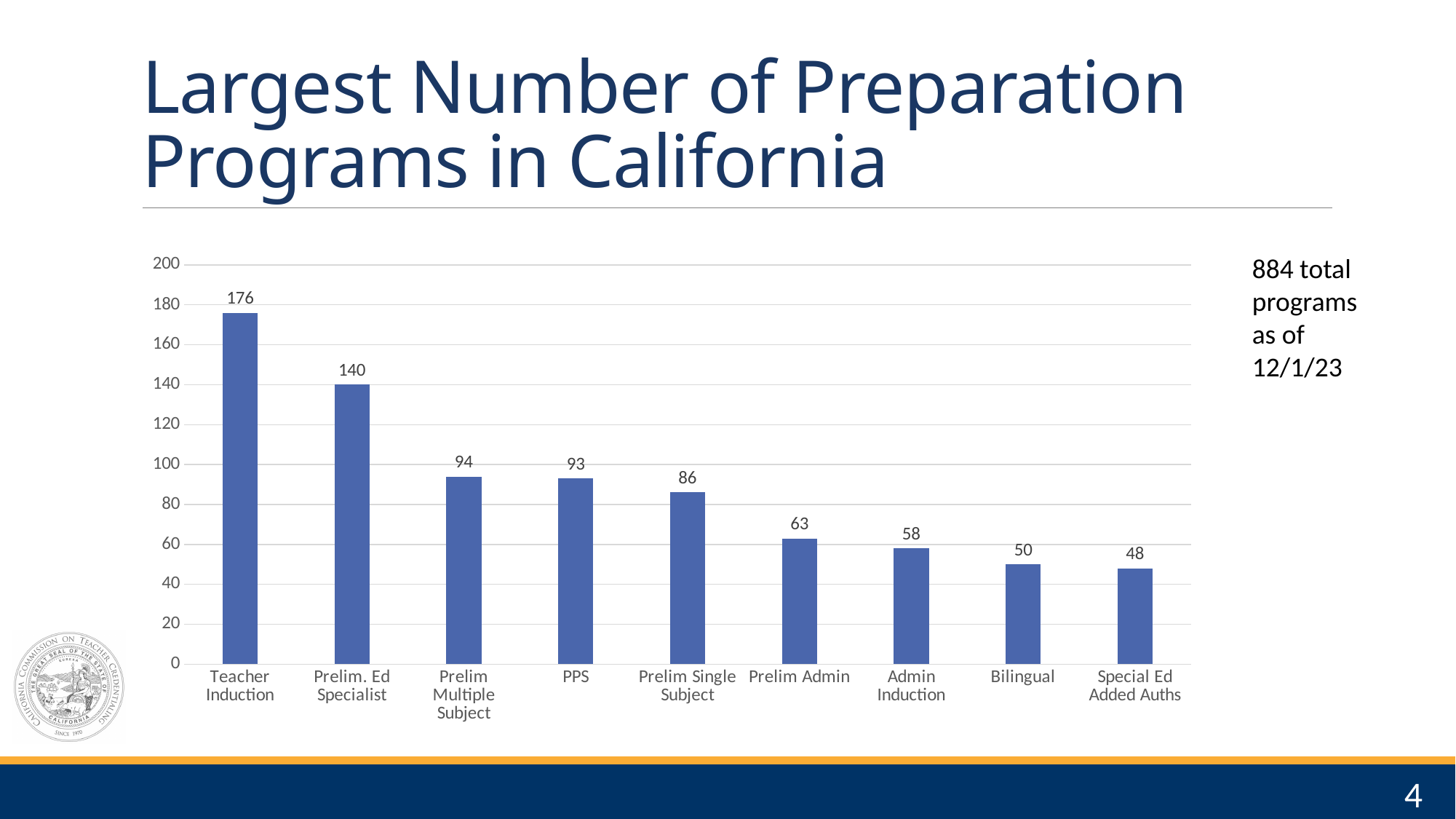
Do the values rise or fall from left to right along the x axis? fall Is the value for PPS greater or less than 100? less Which category has the lowest value? Special Ed Added Auths Which category has the highest value? Teacher Induction What is the value for Bilingual? 50 What is the value for Prelim Single Subject? 86 How many categories are shown on the x axis? 9 What is the difference between Prelim Admin and Admin Induction? 5 Which is larger, Prelim Multiple Subject or Prelim Single Subject? Prelim Multiple Subject What kind of chart is shown on the slide? bar chart What is the value for Teacher Induction? 176 What is the difference between Teacher Induction and Prelim. Ed Specialist? 36